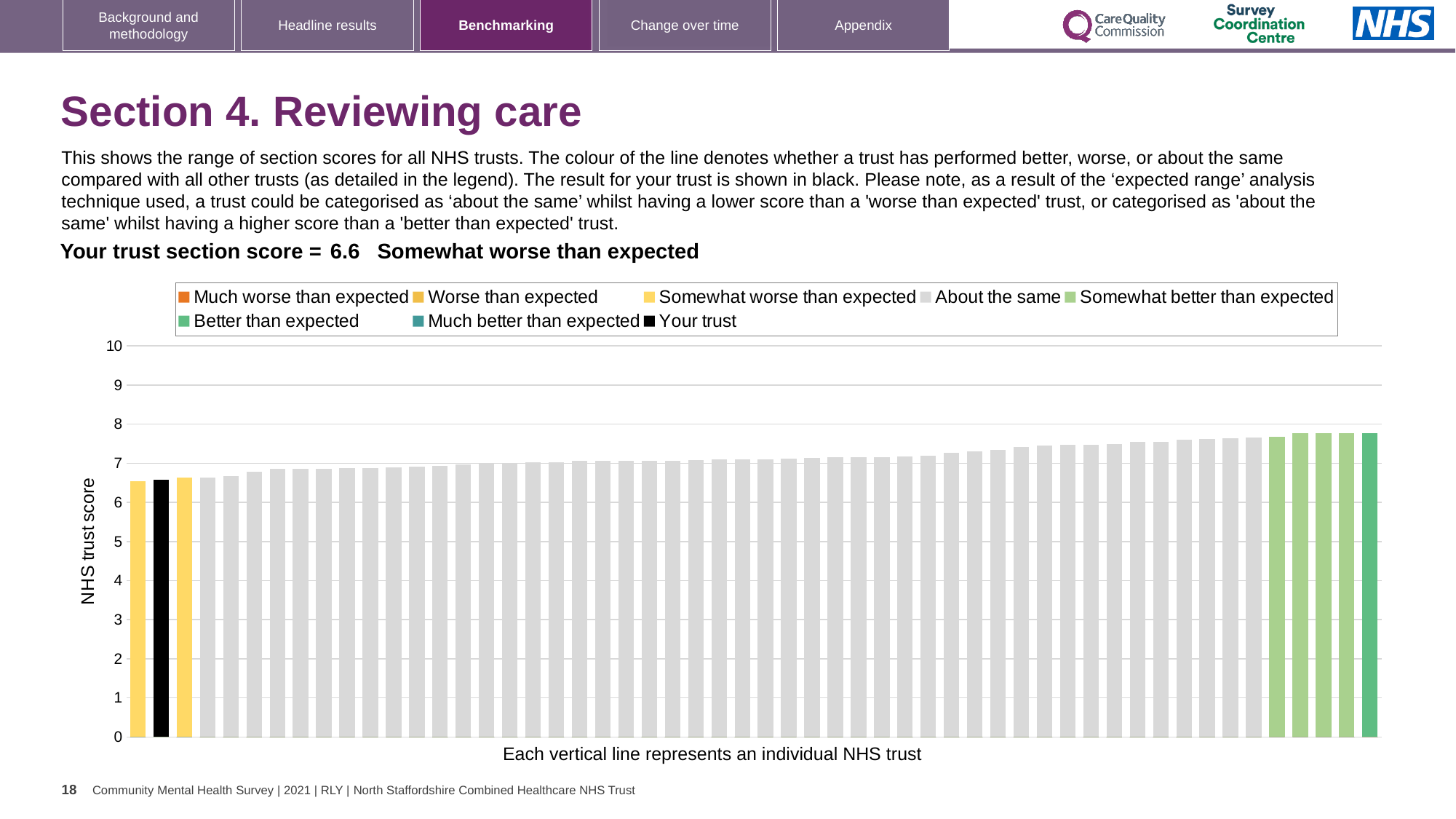
Is the value for your trust greater or less than 5? greater How many entries does the chart legend list? 8 What kind of chart is shown on the slide? bar chart Is the highest bar on the chart greater or less than 8? less What is the label on the vertical axis of the chart? NHS trust score Do the bar values rise or fall from left to right along the x axis? rise What is the section score for your trust? 6.6 Is the value for your trust greater or less than 7? less Which performance category is your trust placed in for this section? Somewhat worse than expected What colour is the bar representing your trust? black